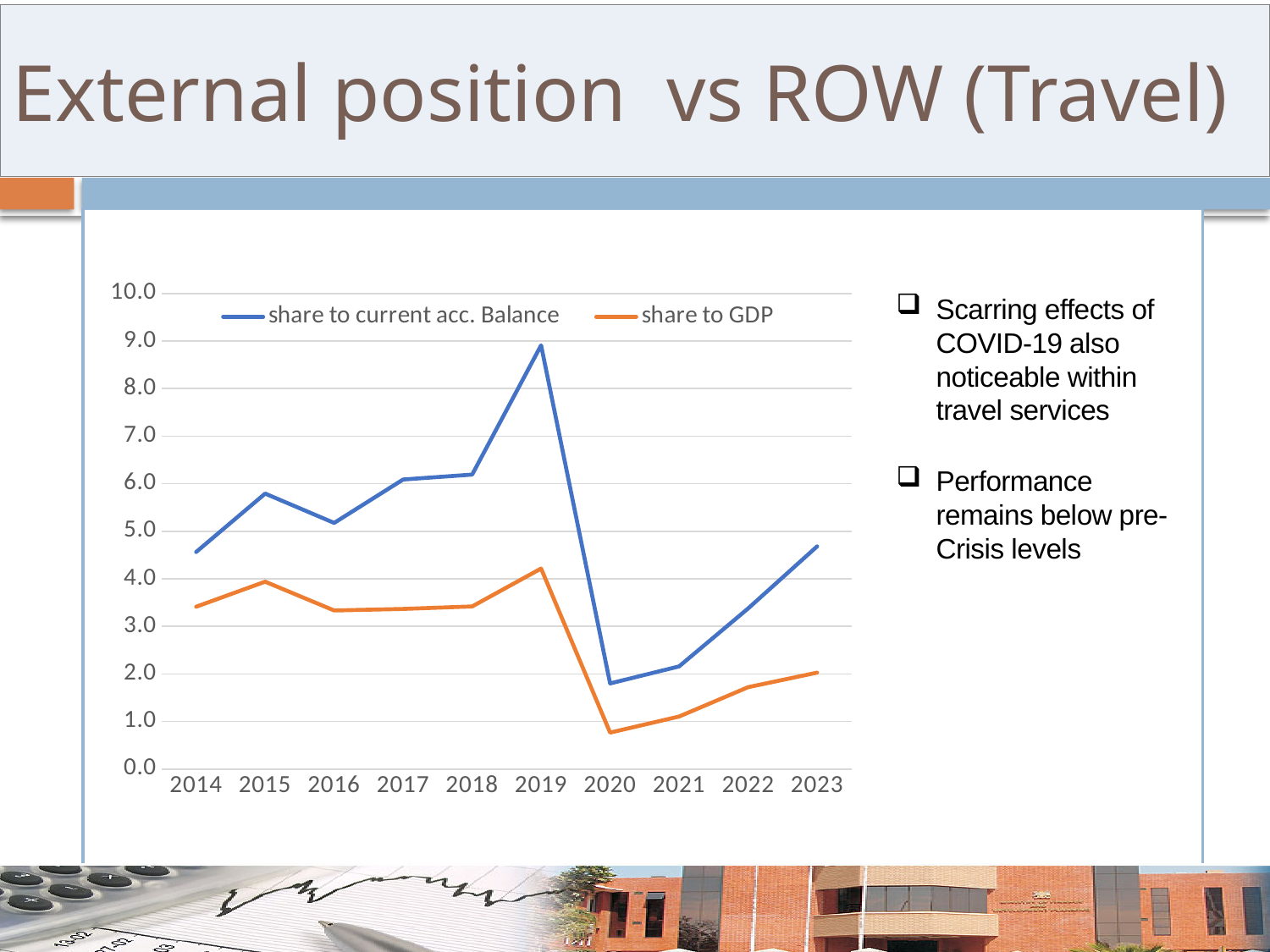
Does the 'share to current acc. Balance' series rise or fall from 2020 to 2023? rise In which year does the 'share to current acc. Balance' series reach its lowest value? 2020 What kind of chart is shown on the slide? line chart In which year does the 'share to GDP' series reach its lowest value? 2020 Is the value for 'share to GDP' in 2020 greater or less than 1.0? less In which year does the 'share to GDP' series reach its highest value? 2019 In which year does the 'share to current acc. Balance' series reach its highest value? 2019 In 2019, which series has the larger value, 'share to current acc. Balance' or 'share to GDP'? share to current acc. Balance How many series does the legend list? 2 How many years are shown on the x axis? 10 Is the value for 'share to current acc. Balance' in 2019 greater or less than 8.0? greater What colour is the line for 'share to GDP'? orange